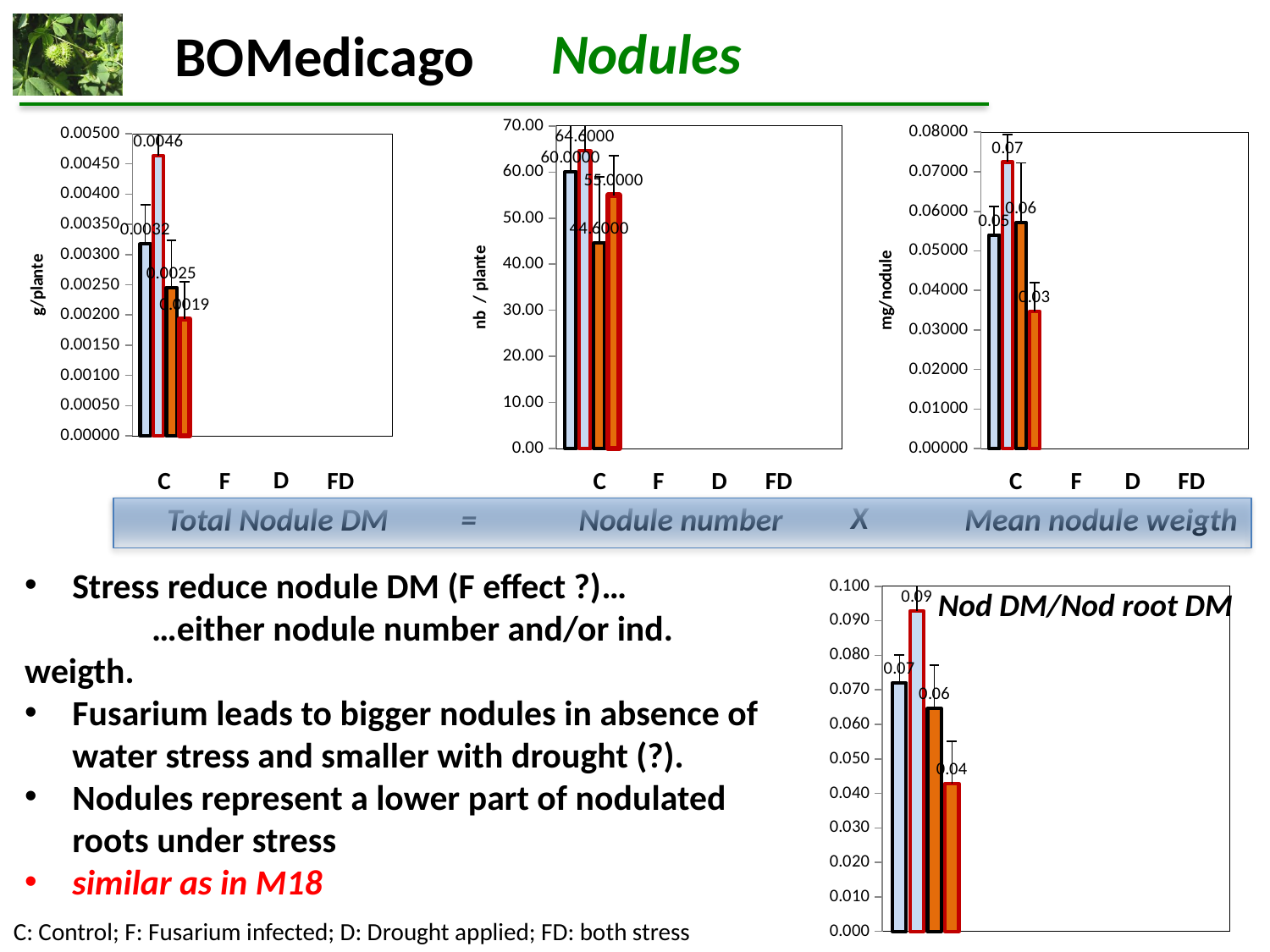
In the Nodule number chart (nb / plante), which category has the highest value? F In the Nodule number chart (nb / plante), what is the difference between the values for F and D? 20.0000 What kind of chart is the Nodule number chart (nb / plante)? bar chart In the Mean nodule weight chart (mg/nodule), which is larger, the value for F or the value for C? F In the Nod DM/Nod root DM chart, is the value for FD greater or less than 0.050? less In the Total Nodule DM chart (g/plante), which category has the lowest value? FD In the Nodule number chart (nb / plante), what is the value for D? 44.6000 How many bars are plotted in the Total Nodule DM chart (g/plante)? 4 In the Nod DM/Nod root DM chart, what is the difference between the values for C and FD? 0.03 In the Nod DM/Nod root DM chart, what is the value for F? 0.09 In the Total Nodule DM chart (g/plante), what is the value for F? 0.0046 In the Mean nodule weight chart (mg/nodule), what is the value for FD? 0.03